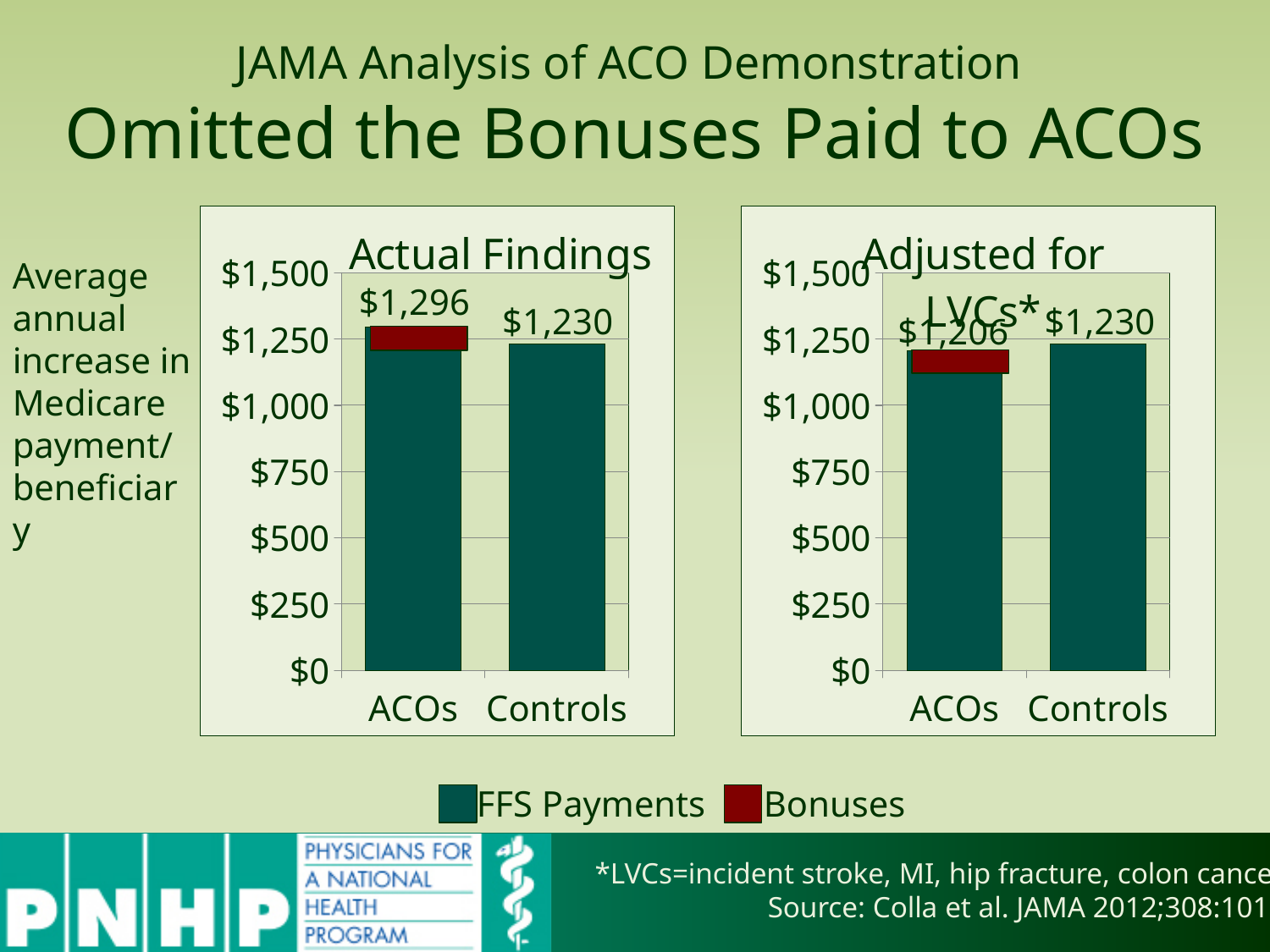
In the Adjusted for LVCs chart, what is the difference between the Controls value and the ACOs total? $24 In the Adjusted for LVCs chart, what is the total value shown for ACOs? $1,206 In the Actual Findings chart, which category has the higher total, ACOs or Controls? ACOs In the Adjusted for LVCs chart, which category has the higher total, ACOs or Controls? Controls In the Adjusted for LVCs chart, what is the value shown for Controls? $1,230 How many series does the legend below the charts list? 2 What kind of chart is the Actual Findings chart? Bar chart In the Actual Findings chart, what is the difference between the ACOs total and the Controls value? $66 How many categories are shown on the x axis of the Actual Findings chart? 2 In the Actual Findings chart, what is the total value shown for ACOs? $1,296 In the Actual Findings chart, what is the value shown for Controls? $1,230 In the Adjusted for LVCs chart, is the total for ACOs greater or less than $1,250? less